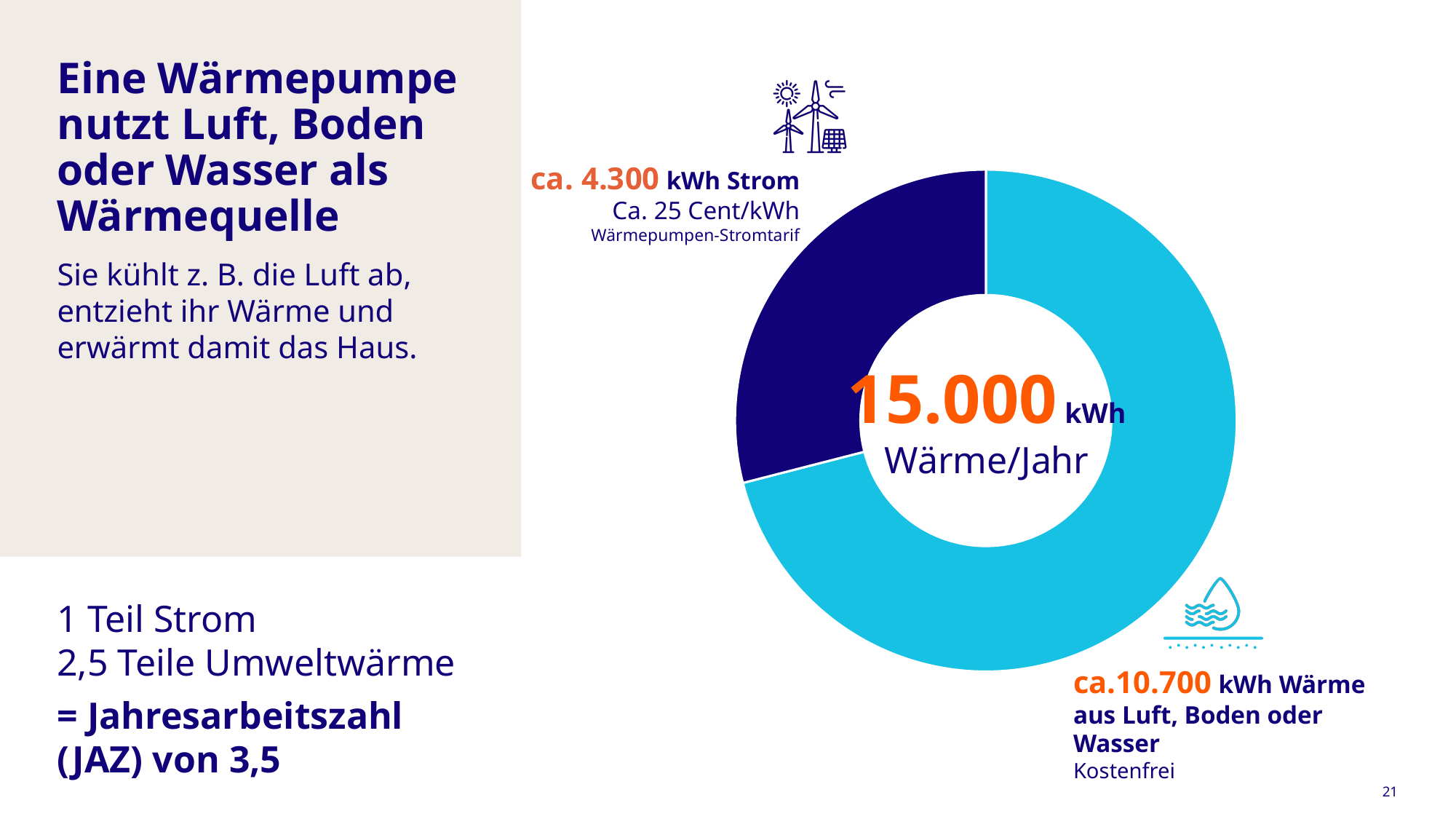
How many segments does the donut chart have? 2 Is the Strom segment larger or smaller than the Wärme aus Luft, Boden oder Wasser segment? Smaller What total value is printed in the centre of the donut chart? 15.000 kWh Wärme/Jahr What value is shown for the Strom (electricity) segment of the chart? ca. 4.300 kWh Which segment of the chart is the smallest? Strom (ca. 4.300 kWh) What electricity price per kWh is given next to the Strom segment? Ca. 25 Cent/kWh What colour is the Strom segment of the donut chart? Dark blue What kind of chart is shown on the slide? Pie (donut) chart What value is shown for the Wärme aus Luft, Boden oder Wasser segment of the chart? ca. 10.700 kWh What is the difference in kWh between the Wärme aus Luft, Boden oder Wasser segment and the Strom segment? 6.400 kWh Which segment of the chart is the largest? Wärme aus Luft, Boden oder Wasser (ca. 10.700 kWh)